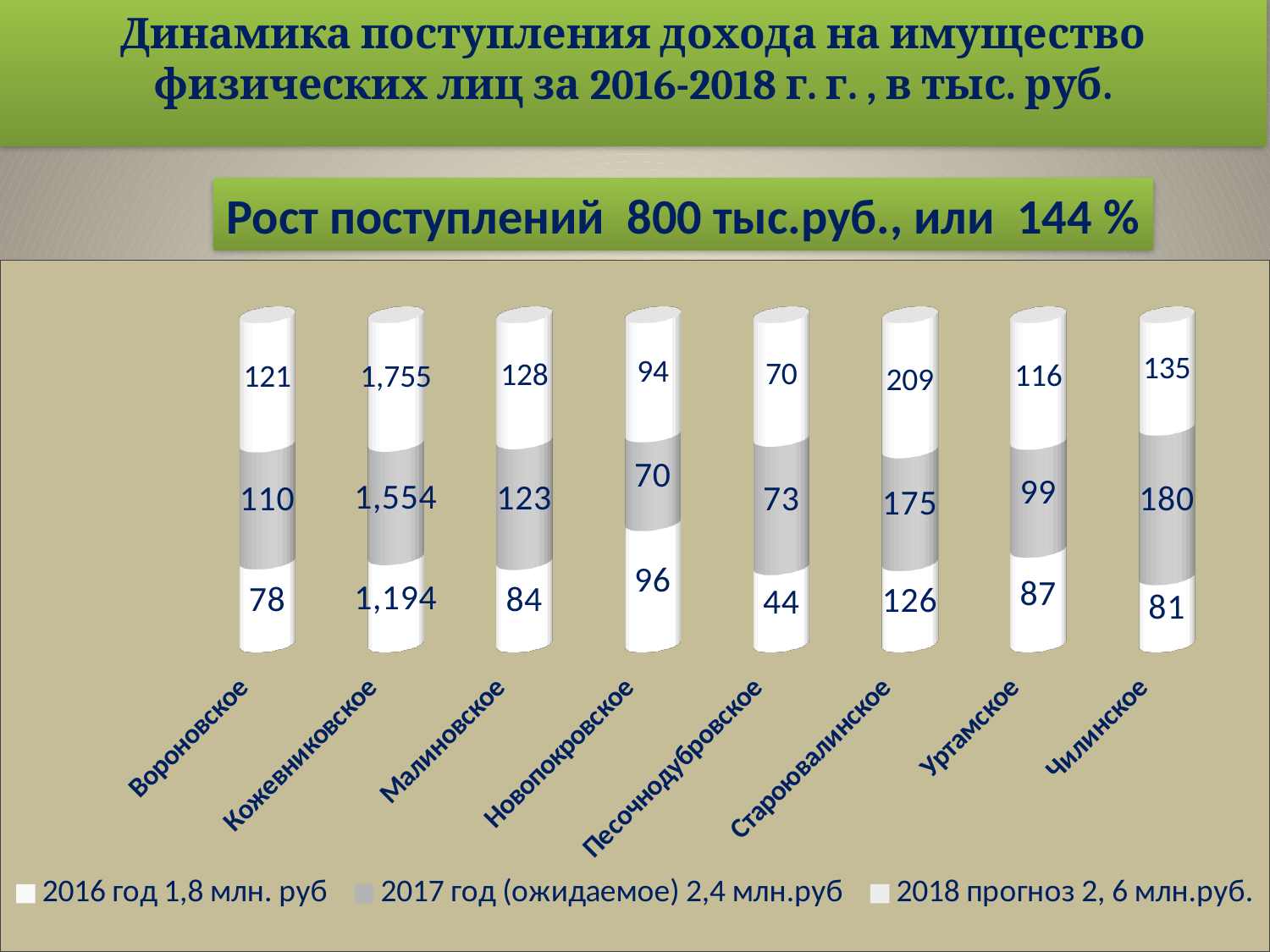
Which category has the highest 2018 forecast value? Кожевниковское Which is larger for Новопокровское: the 2016 value or the 2017 (ожидаемое) value? 2016 value How many categories (settlements) are shown on the x axis? 8 What is the 2018 forecast value for Староювалинское? 209 What is the 2016 value for Кожевниковское? 1,194 What kind of chart is shown on the slide? Stacked bar chart What is the 2017 (ожидаемое) value for Чилинское? 180 What is the title of the chart on the slide? Динамика поступления дохода на имущество физических лиц за 2016-2018 г. г. , в тыс. руб. Which category has the lowest 2016 value? Песочнодубровское What is the difference between the 2018 forecast and 2016 values for Вороновское? 43 How many series does the legend list? 3 What is the total of the three stacked values for Уртамское? 302